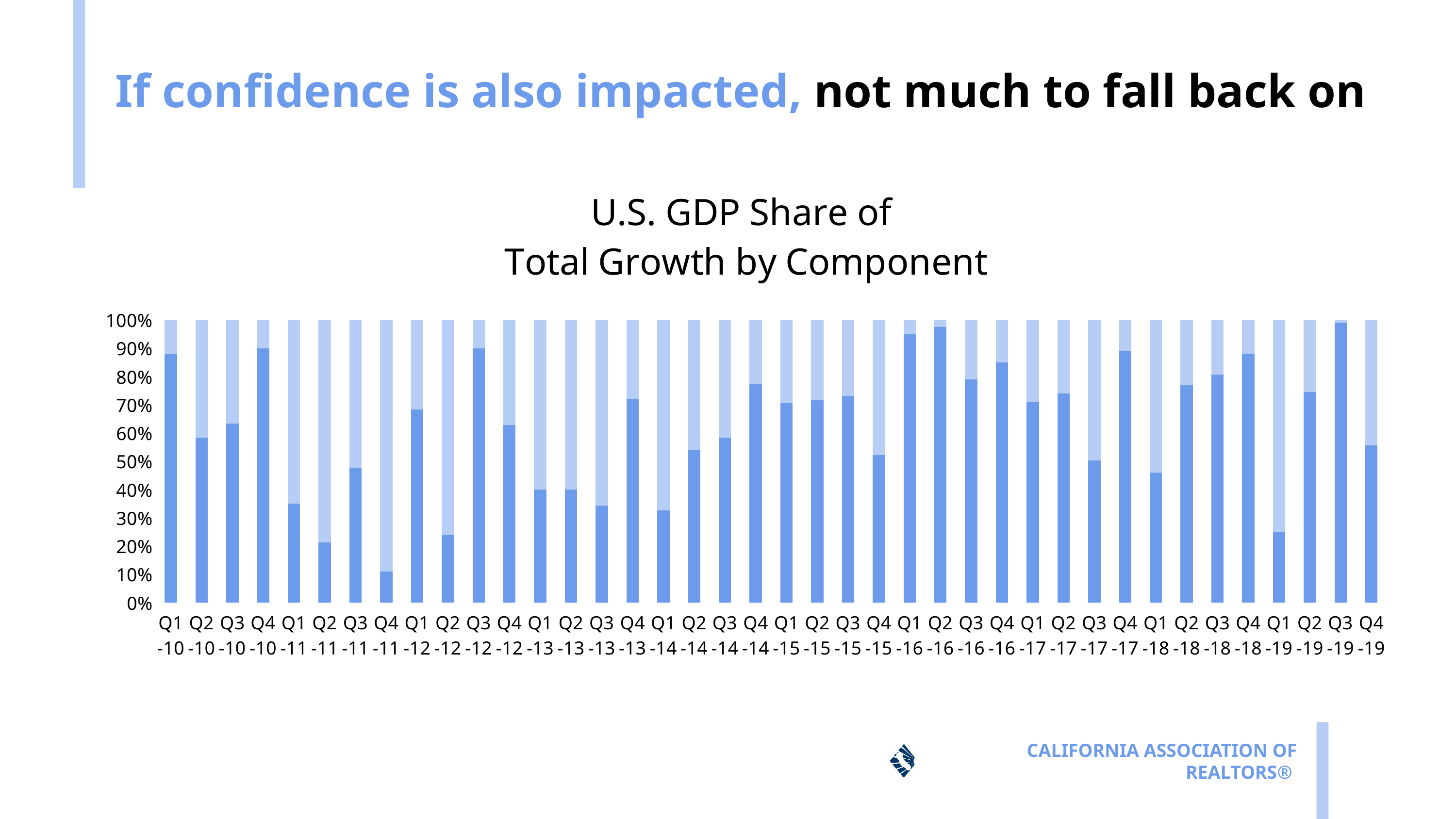
Which has the larger dark blue segment, Q1-10 or Q2-10? Q1-10 Which has the larger dark blue segment, Q4-11 or Q1-12? Q1-12 Which quarter has the lowest dark blue segment? Q4-11 Is the dark blue segment for Q3-19 greater or less than 90%? greater What is the title of the chart? U.S. GDP Share of Total Growth by Component Is the dark blue segment for Q2-16 greater or less than 90%? greater What is the total height of each stacked bar, as shown on the y axis? 100% How many quarters (bars) are plotted on the x axis? 40 What type of chart is shown on the slide? bar chart Is the dark blue segment for Q1-10 greater or less than 80%? greater